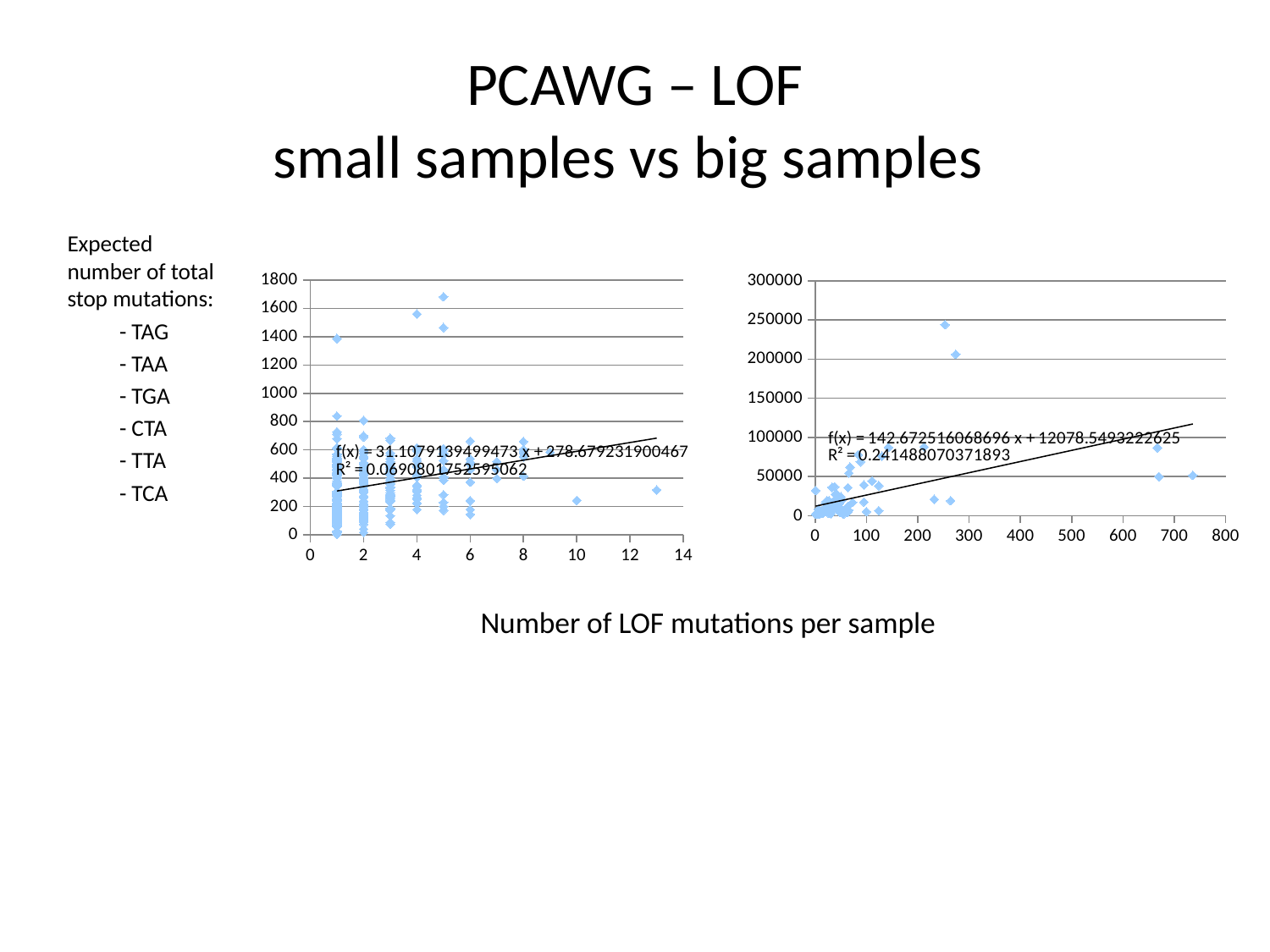
On the left chart, does the fitted trendline rise or fall as the x value increases? rise What is the maximum value shown on the y axis of the right chart? 300000 What kind of chart is the left chart on the slide? scatter chart On the right chart, what R² value is printed for the trendline? R² = 0.241488070371893 Which chart has the larger R² value for its trendline, the left chart or the right chart? the right chart On the right chart, is the highest plotted point greater or less than 200000? greater On the left chart, is the highest plotted point greater or less than 1600? greater On the left chart, what is the equation of the fitted trendline shown? f(x) = 31.1079139499473 x + 278.679231900467 On the left chart, what R² value is printed for the trendline? R² = 0.0690801752595062 What kind of chart is the right chart on the slide? scatter chart On the right chart, what is the equation of the fitted trendline shown? f(x) = 142.672516068696 x + 12078.5493222625 On the right chart, does the fitted trendline rise or fall as the x value increases? rise